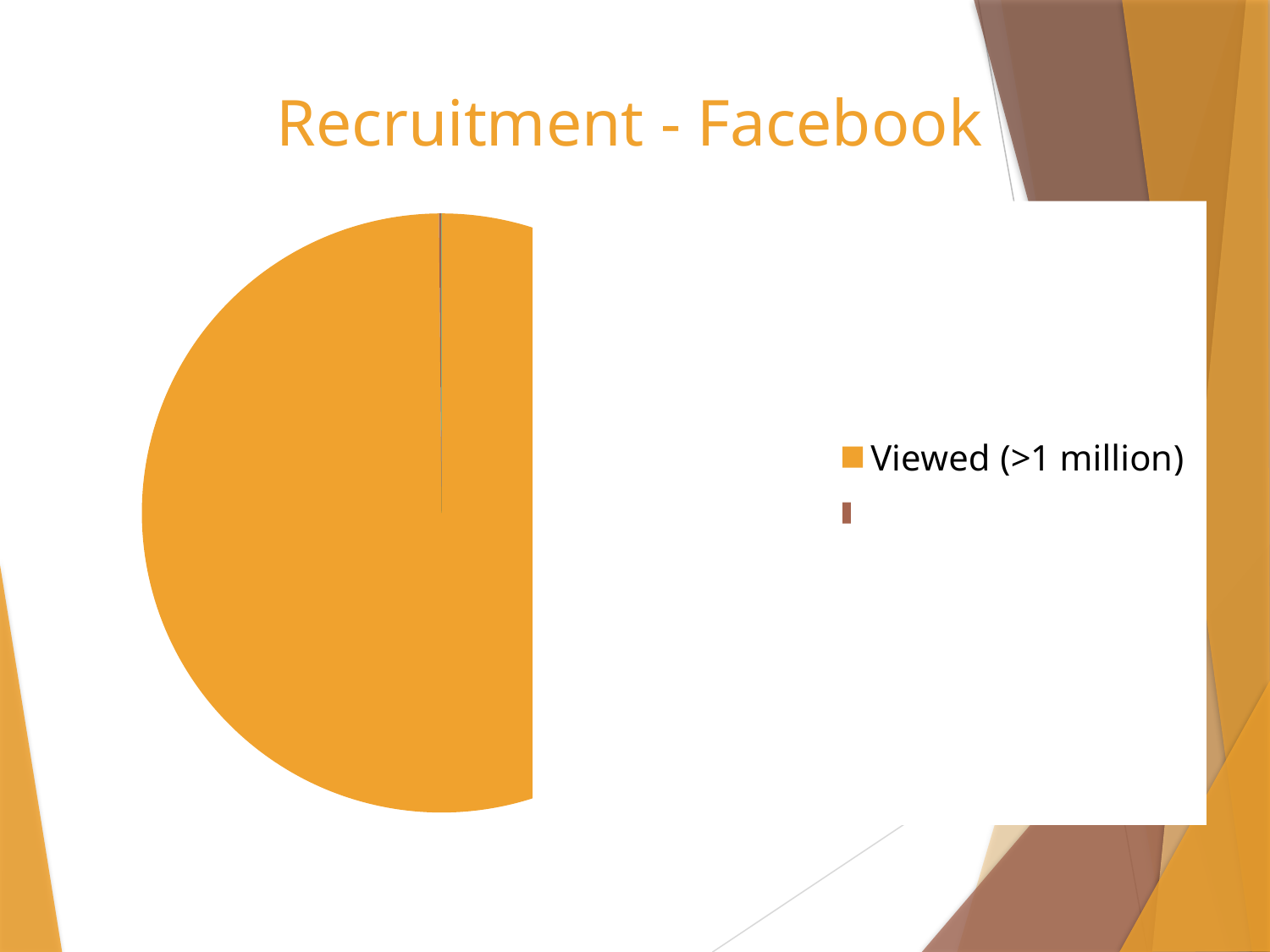
How many entries does the legend list? 2 What kind of chart is shown on the slide? pie chart How many slices does the pie chart have? 2 Does the Viewed (>1 million) slice take up more or less than half of the pie? more What is the title of the slide containing the pie chart? Recruitment - Facebook Which category has the largest slice of the pie? Viewed (>1 million) What colour is the slice for Viewed (>1 million)? orange